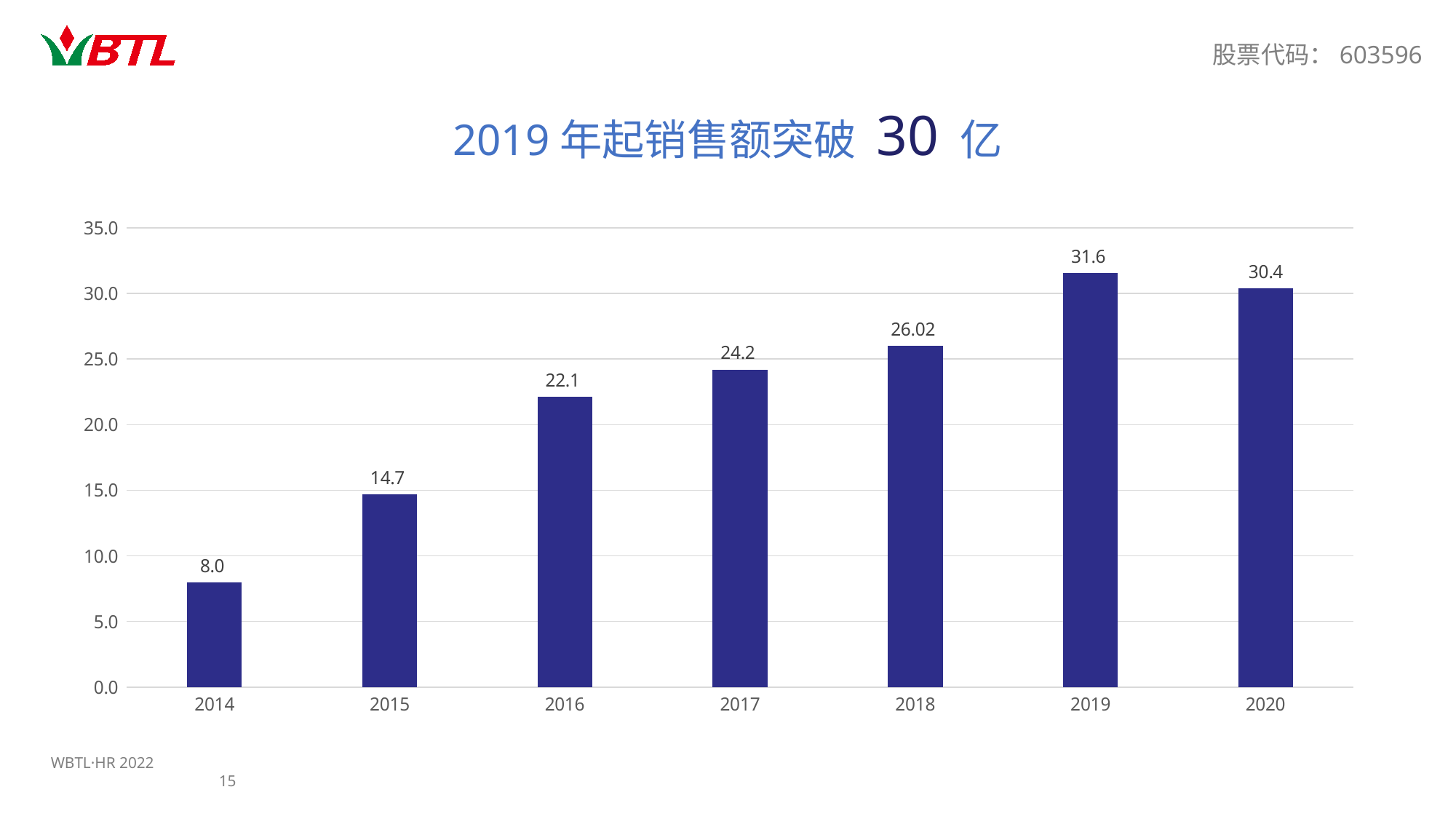
How many years are shown on the x axis? 7 What is the difference between the values for 2019 and 2020? 1.2 Which year has the highest value? 2019 What is the value for 2020? 30.4 Do the values rise or fall from 2014 to 2019? Rise What is the difference between the values for 2015 and 2014? 6.7 Is the value for 2018 greater or less than 25.0? greater What is the value for 2018? 26.02 What kind of chart is shown on the slide? Bar chart Which is larger, the value for 2016 or the value for 2017? 2017 Which year has the lowest value? 2014 What is the value for 2014? 8.0